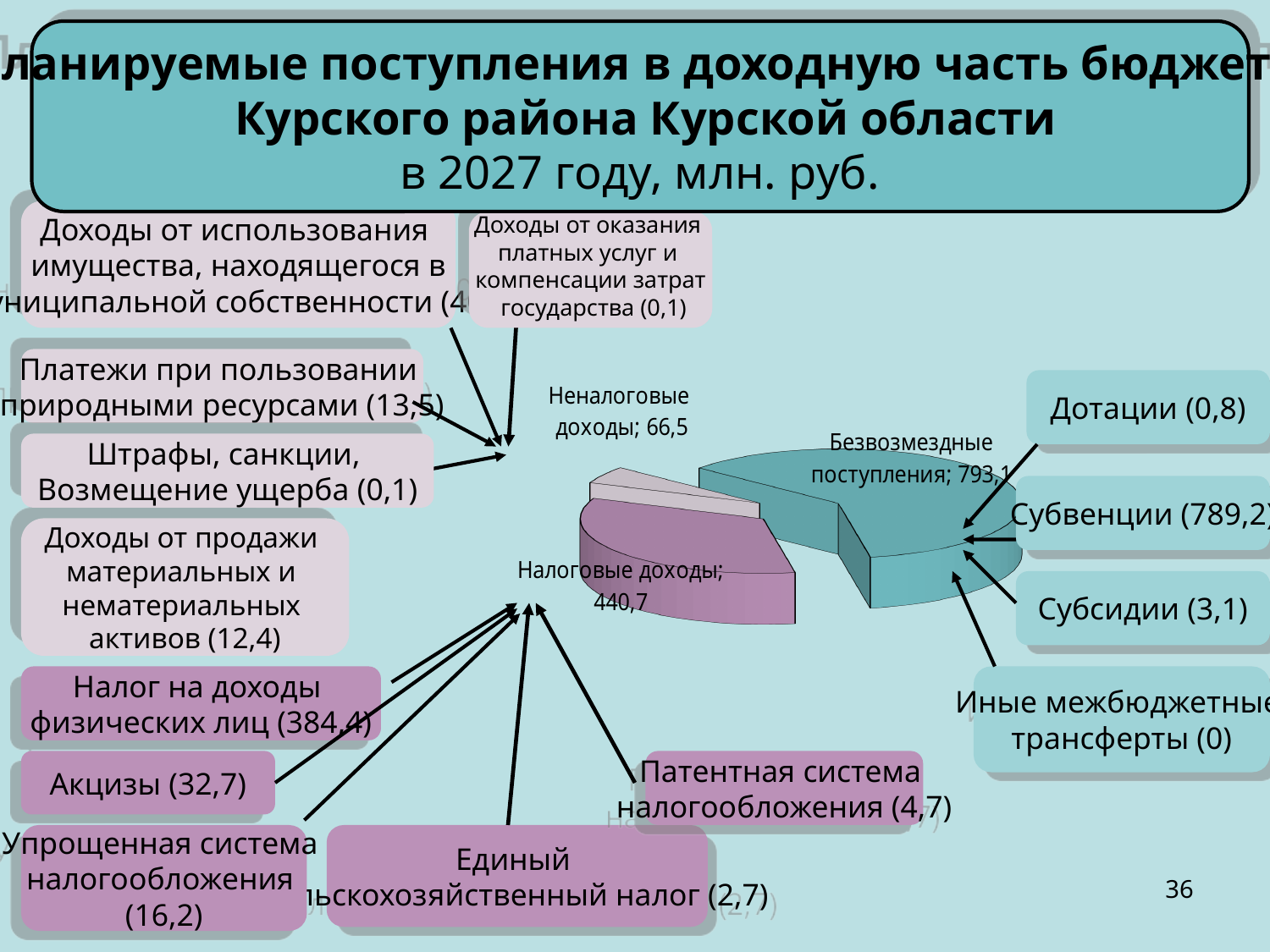
In what units are the values in the chart expressed, according to the title? млн. руб. Which category has the smallest slice in the pie chart? Неналоговые доходы What colour is the Налоговые доходы slice in the pie chart? Purple Which category has the largest slice in the pie chart? Безвозмездные поступления What is the value for Налоговые доходы in the pie chart? 440,7 What is the value for Безвозмездные поступления in the pie chart? 793,1 Which is larger, Налоговые доходы or Неналоговые доходы? Налоговые доходы How many slices does the pie chart have? 3 What is the difference between Налоговые доходы and Неналоговые доходы? 374,2 What type of chart is shown on the slide? Pie chart What is the value for Неналоговые доходы in the pie chart? 66,5 What is the difference between Безвозмездные поступления and Налоговые доходы? 352,4